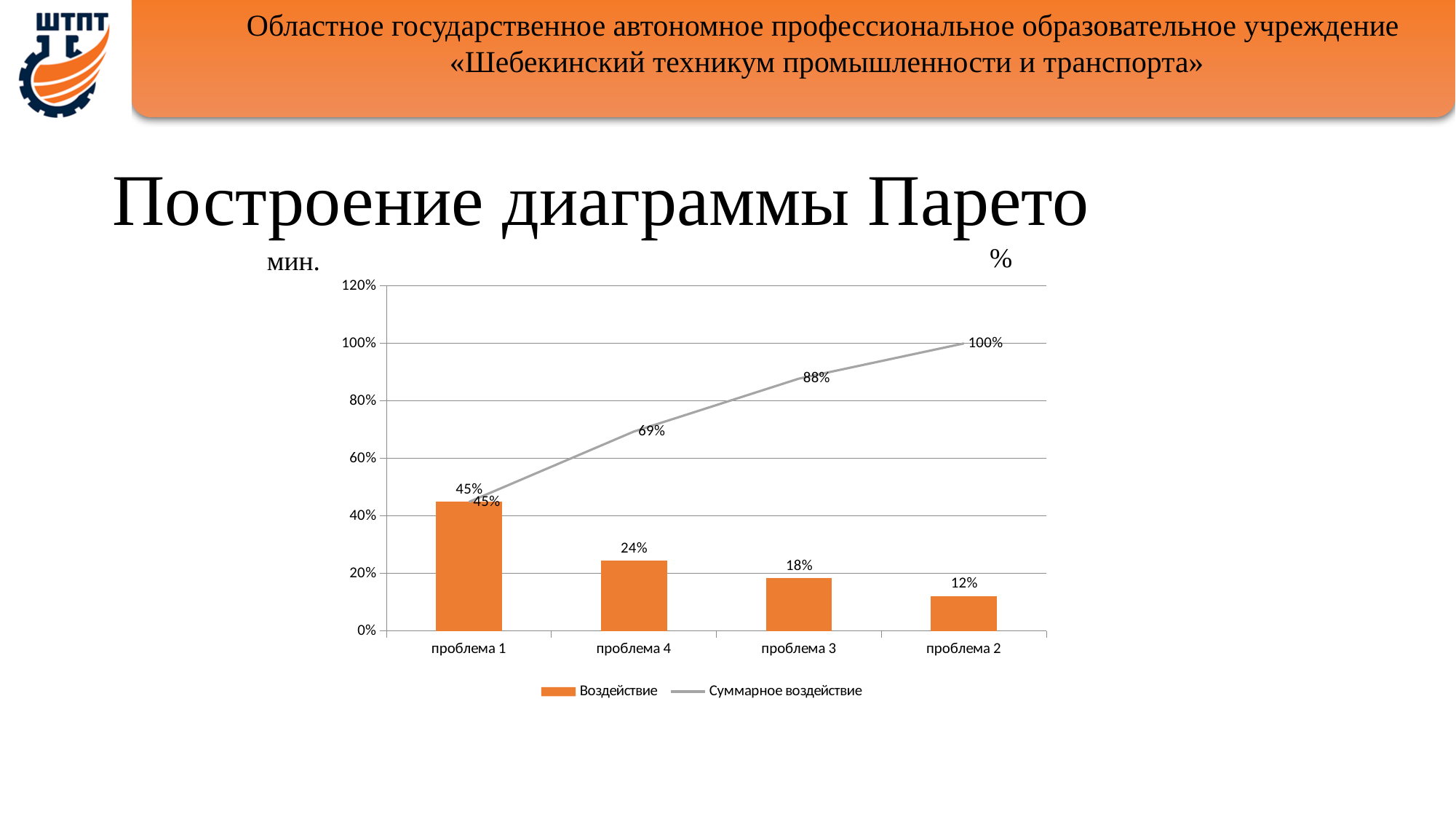
Which category has the lowest Воздействие value? проблема 2 What is the value of Суммарное воздействие at проблема 4? 69% Which is larger, the Воздействие value for проблема 4 or for проблема 3? проблема 4 What is the value of Воздействие for проблема 2? 12% What is the value of Суммарное воздействие at проблема 3? 88% Which category has the highest Воздействие value? проблема 1 How many series does the legend list? 2 Do the Суммарное воздействие values rise or fall from left to right along the x axis? rise What is the value of Воздействие for проблема 4? 24% What is the difference between the Воздействие values for проблема 1 and проблема 3? 27% What is the value of Воздействие for проблема 1? 45% How many categories are shown on the x axis? 4